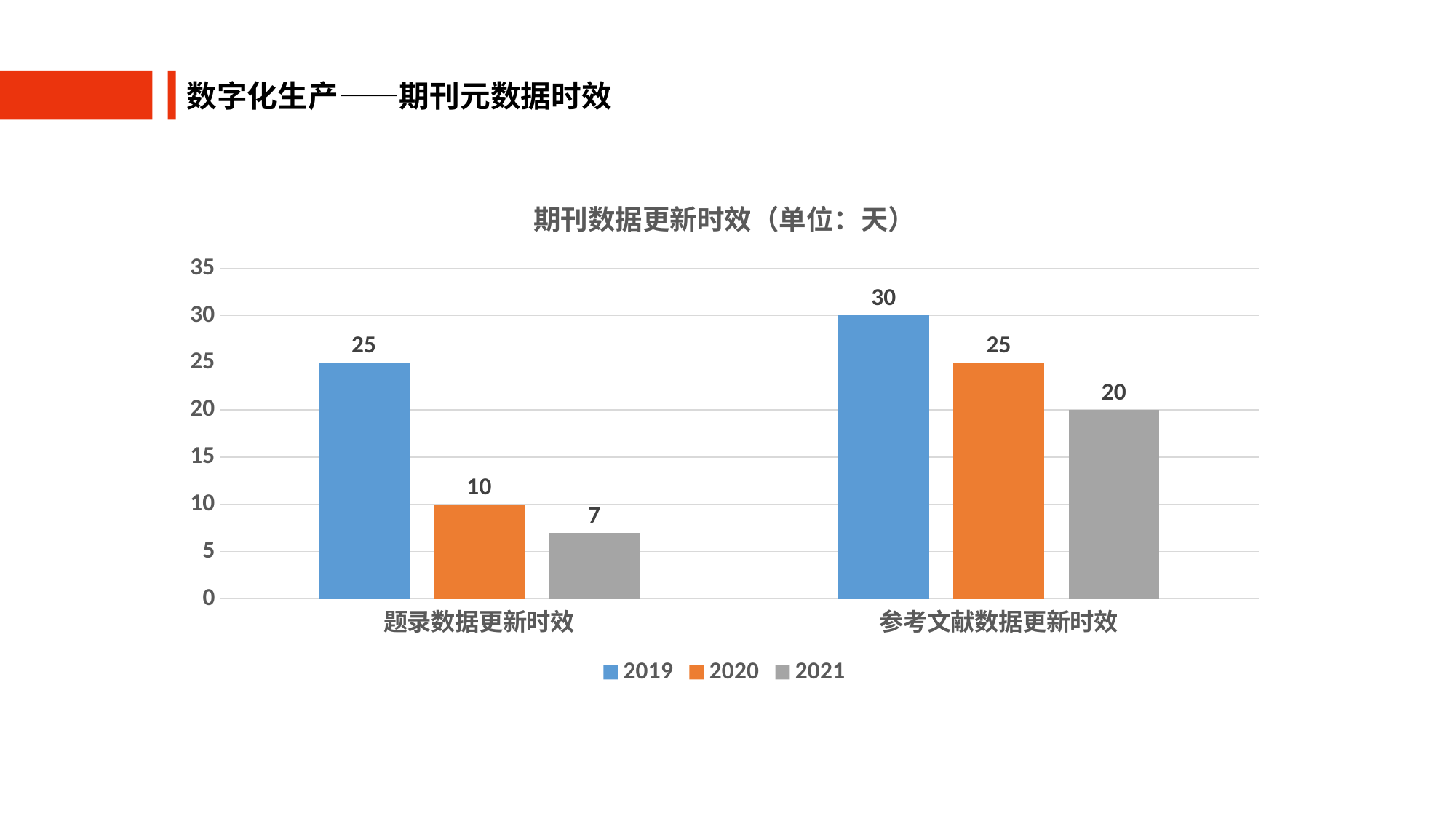
How many categories are shown on the x axis? 2 What is the value for 2020 in the 题录数据更新时效 category? 10 What is the difference between the 2019 and 2020 values in the 参考文献数据更新时效 category? 5 Which is larger: the 2020 value for 题录数据更新时效 or the 2020 value for 参考文献数据更新时效? 参考文献数据更新时效 How many series does the legend list? 3 What kind of chart is shown on the slide? Bar chart Which year has the lowest value in the 题录数据更新时效 category? 2021 Which year has the highest value in the 参考文献数据更新时效 category? 2019 What is the value for 2021 in the 参考文献数据更新时效 category? 20 What is the difference between the 2019 and 2021 values in the 题录数据更新时效 category? 18 What is the value for 2019 in the 题录数据更新时效 category? 25 What is the title of the chart? 期刊数据更新时效（单位：天）